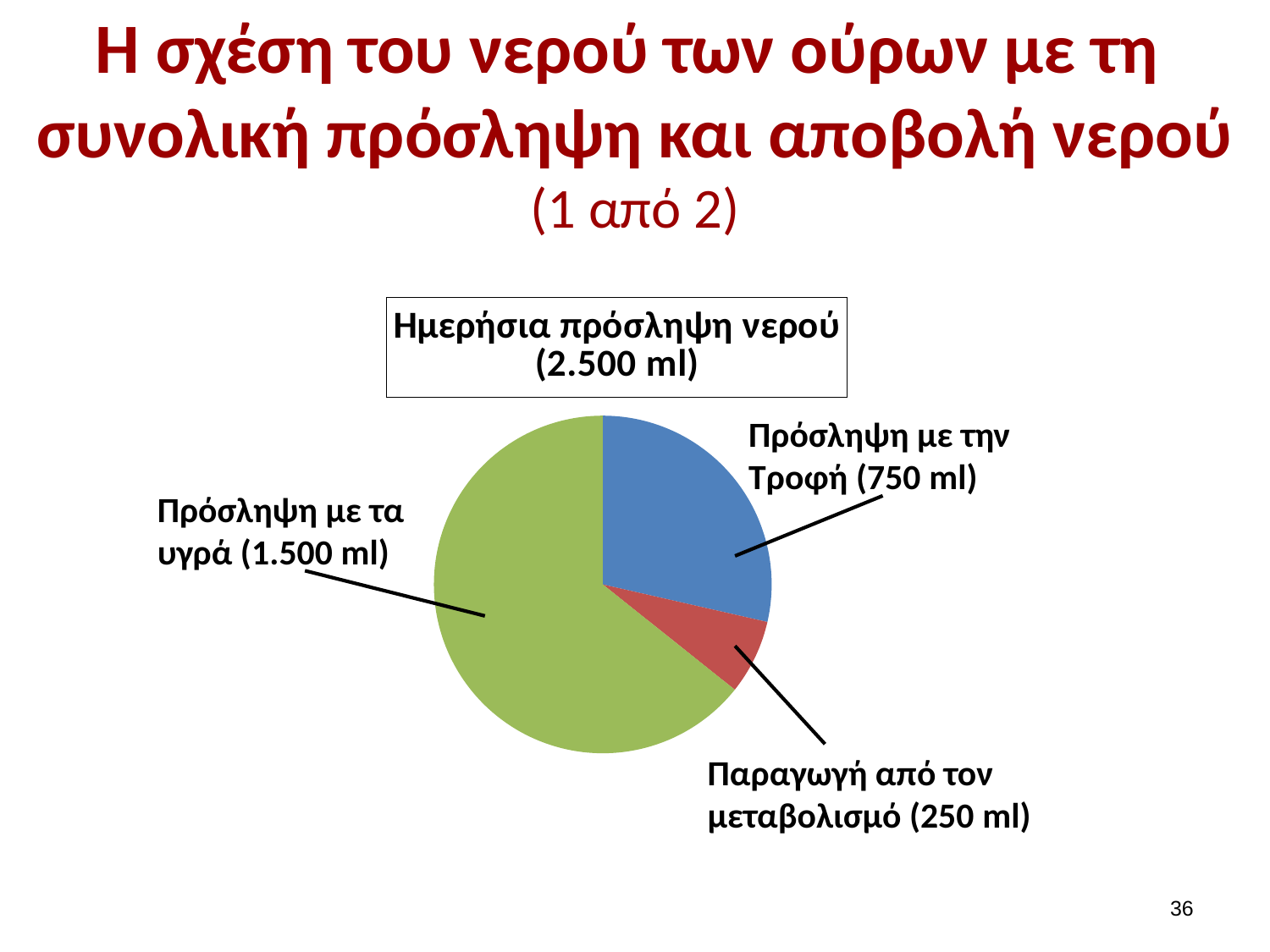
How many slices does the pie chart have? 3 What is the title of the pie chart? Ημερήσια πρόσληψη νερού (2.500 ml) What share of the total daily water intake does Πρόσληψη με τα υγρά represent? 60% What is the value for Πρόσληψη με τα υγρά? 1.500 ml What is the value for Παραγωγή από τον μεταβολισμό? 250 ml Which is larger, Πρόσληψη με την Τροφή or Παραγωγή από τον μεταβολισμό? Πρόσληψη με την Τροφή What kind of chart is shown on the slide? pie chart What is the difference between Πρόσληψη με τα υγρά and Πρόσληψη με την Τροφή? 750 ml What is the value for Πρόσληψη με την Τροφή? 750 ml Which category has the smallest slice of the pie? Παραγωγή από τον μεταβολισμό Which category has the largest slice of the pie? Πρόσληψη με τα υγρά What colour is the slice for Παραγωγή από τον μεταβολισμό? red